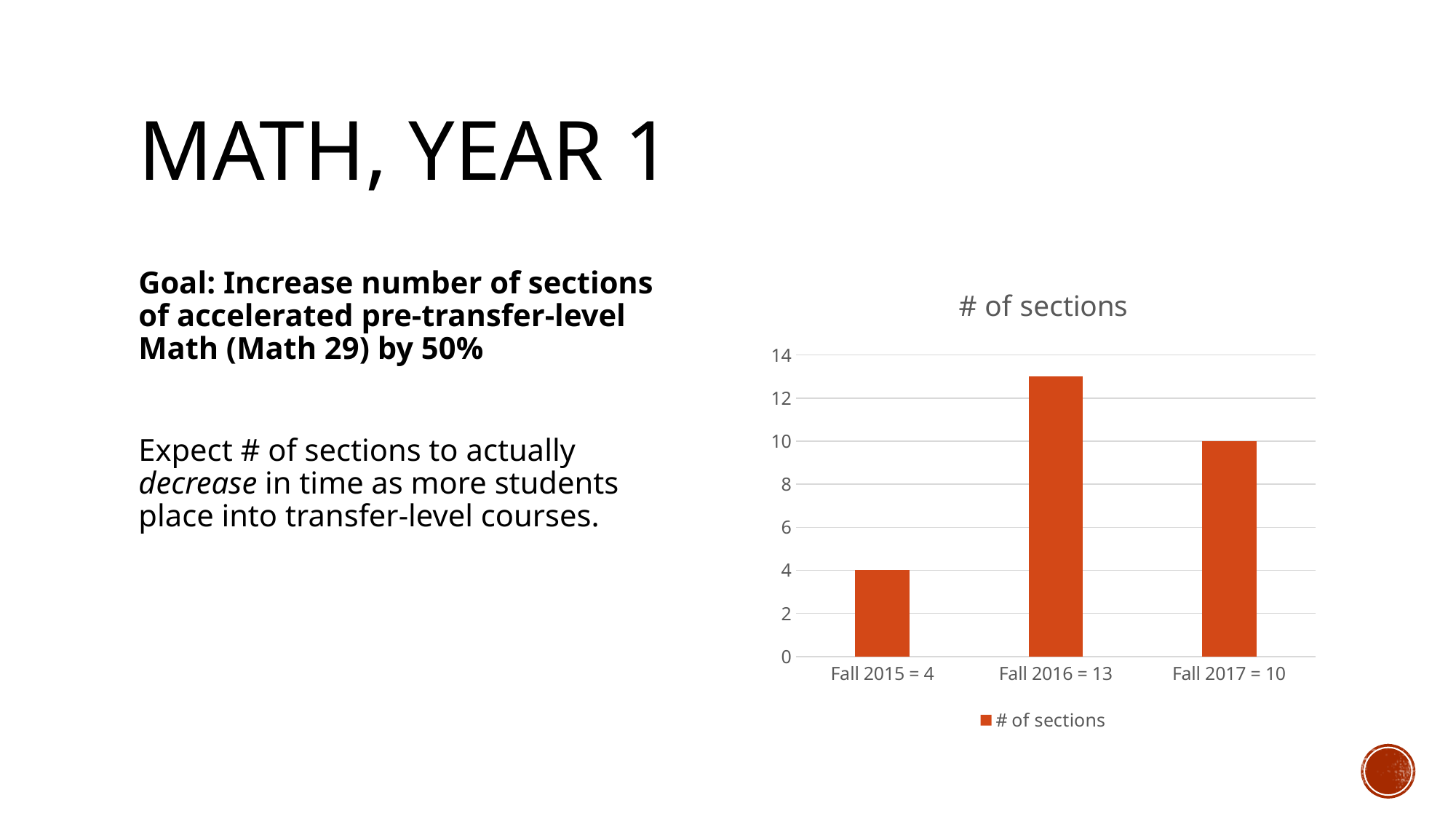
What is the number of sections for Fall 2016? 13 Which term has the highest number of sections? Fall 2016 How many series does the chart legend list? 1 Which term has the lowest number of sections? Fall 2015 What is the number of sections for Fall 2015? 4 What is the difference in number of sections between Fall 2016 and Fall 2017? 3 How many terms are shown on the x axis of the chart? 3 What is the difference in number of sections between Fall 2016 and Fall 2015? 9 What is the title of the chart? # of sections What is the number of sections for Fall 2017? 10 What kind of chart is shown on the slide? Bar chart Which has more sections, Fall 2017 or Fall 2015? Fall 2017